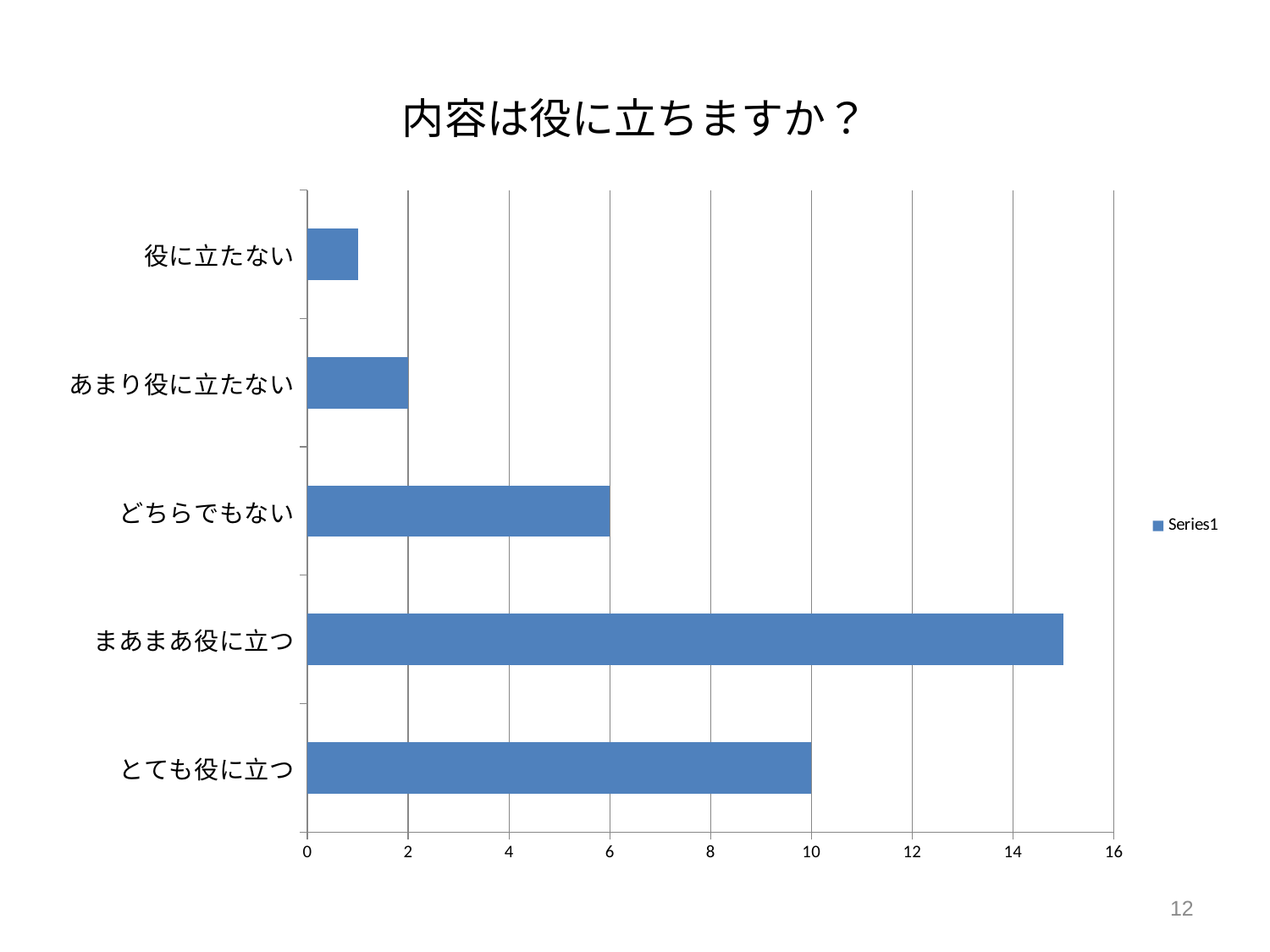
What is the value for どちらでもない? 6 What type of chart is shown on the slide? bar chart What is the difference between the values for とても役に立つ and どちらでもない? 4 What is the value for あまり役に立たない? 2 Which category has the lowest value? 役に立たない What is the title of the chart? 内容は役に立ちますか？ Which category has the highest value? まあまあ役に立つ Is the value for まあまあ役に立つ greater or less than 14? greater How many categories are shown in the chart? 5 What is the value for とても役に立つ? 10 Which is larger, the value for とても役に立つ or the value for まあまあ役に立つ? まあまあ役に立つ How many series does the legend list? 1